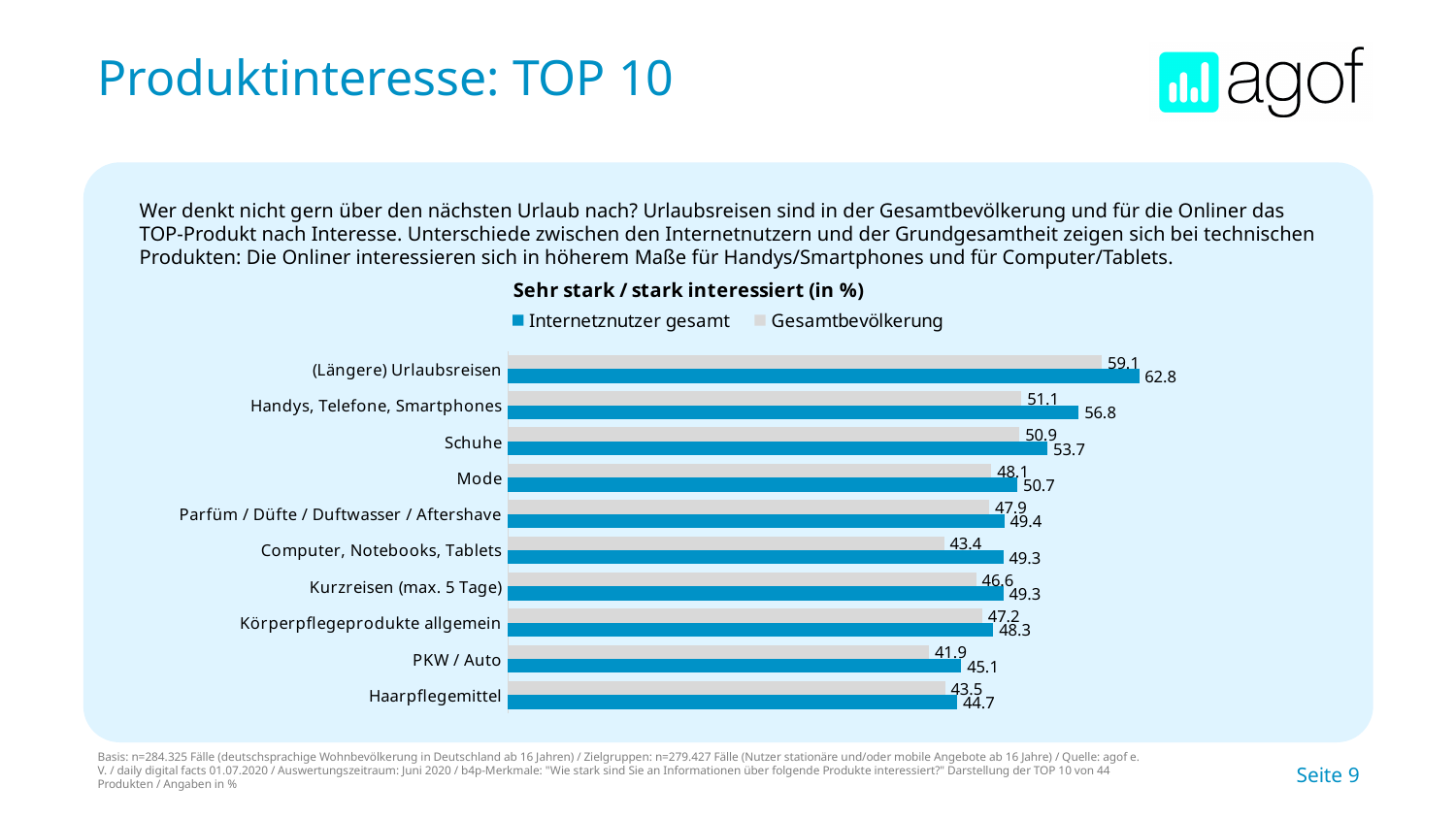
What is the value for Internetnutzer gesamt for (Längere) Urlaubsreisen? 62,8 Which category has the lowest value for Gesamtbevölkerung? PKW / Auto What is the title of the chart? Sehr stark / stark interessiert (in %) What kind of chart is shown on the slide? Bar chart What is the value for Gesamtbevölkerung for PKW / Auto? 41,9 How many series does the legend list? 2 Which is larger for Schuhe: the Internetnutzer gesamt value or the Gesamtbevölkerung value? Internetnutzer gesamt What is the value for Gesamtbevölkerung for Computer, Notebooks, Tablets? 43,4 How many product categories are shown in the chart? 10 What is the difference between the Internetnutzer gesamt and Gesamtbevölkerung values for Computer, Notebooks, Tablets? 5,9 Which category has the highest value for Internetnutzer gesamt? (Längere) Urlaubsreisen What is the difference between the Internetnutzer gesamt and Gesamtbevölkerung values for Handys, Telefone, Smartphones? 5,7